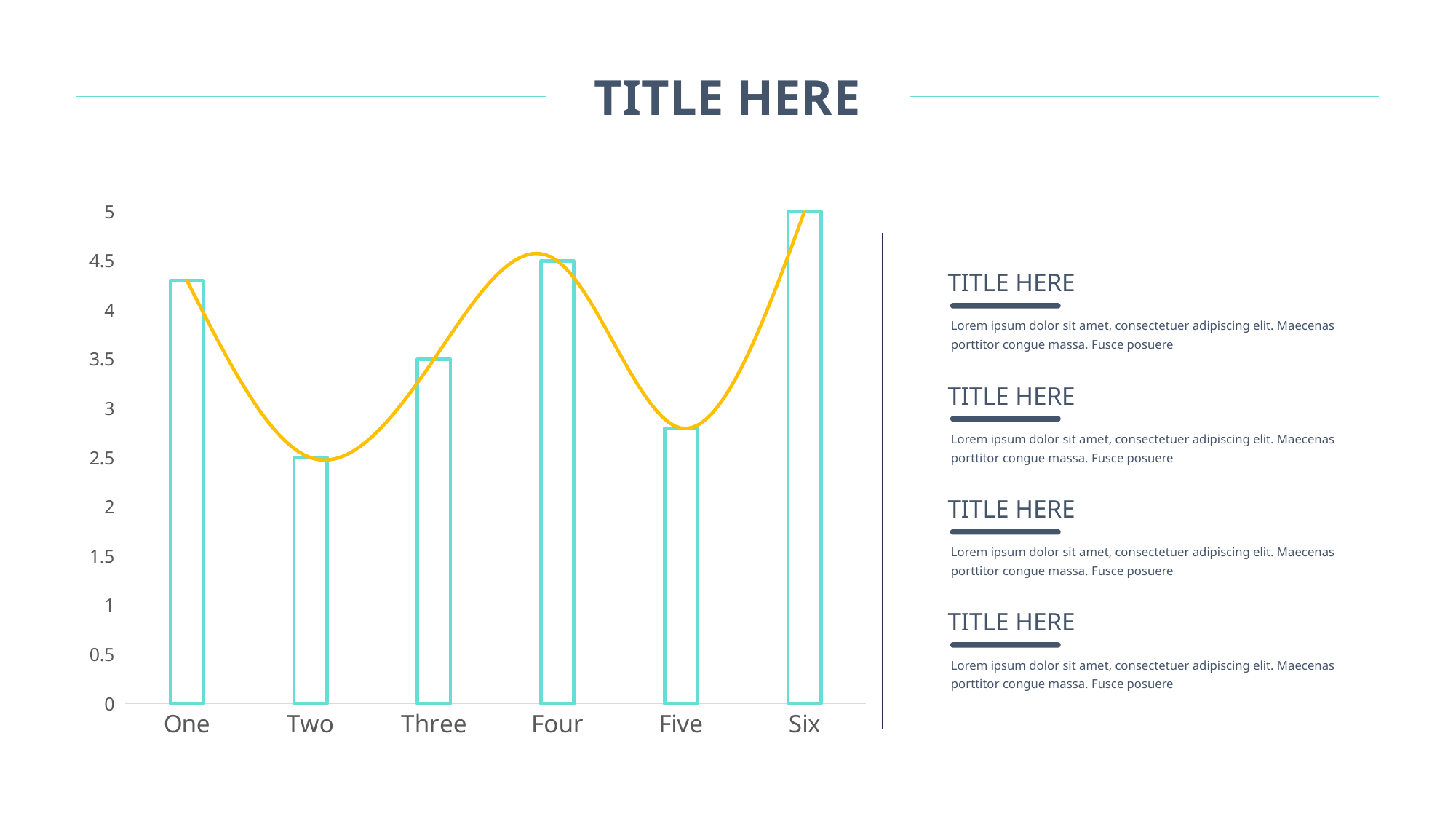
What is the value of the bar for Six? 5 What is the difference between the values for Four and Three? 1 Which category has the lowest bar? Two How many categories are shown on the x axis? 6 Which category has the highest bar? Six What is the value of the bar for Three? 3.5 Is the value for One greater or less than 4? greater What is the value of the bar for Two? 2.5 What is the value of the bar for Four? 4.5 What is the difference between the values for Six and Two? 2.5 Is the value for Five greater or less than 3? less Which is larger, the bar for One or the bar for Five? One